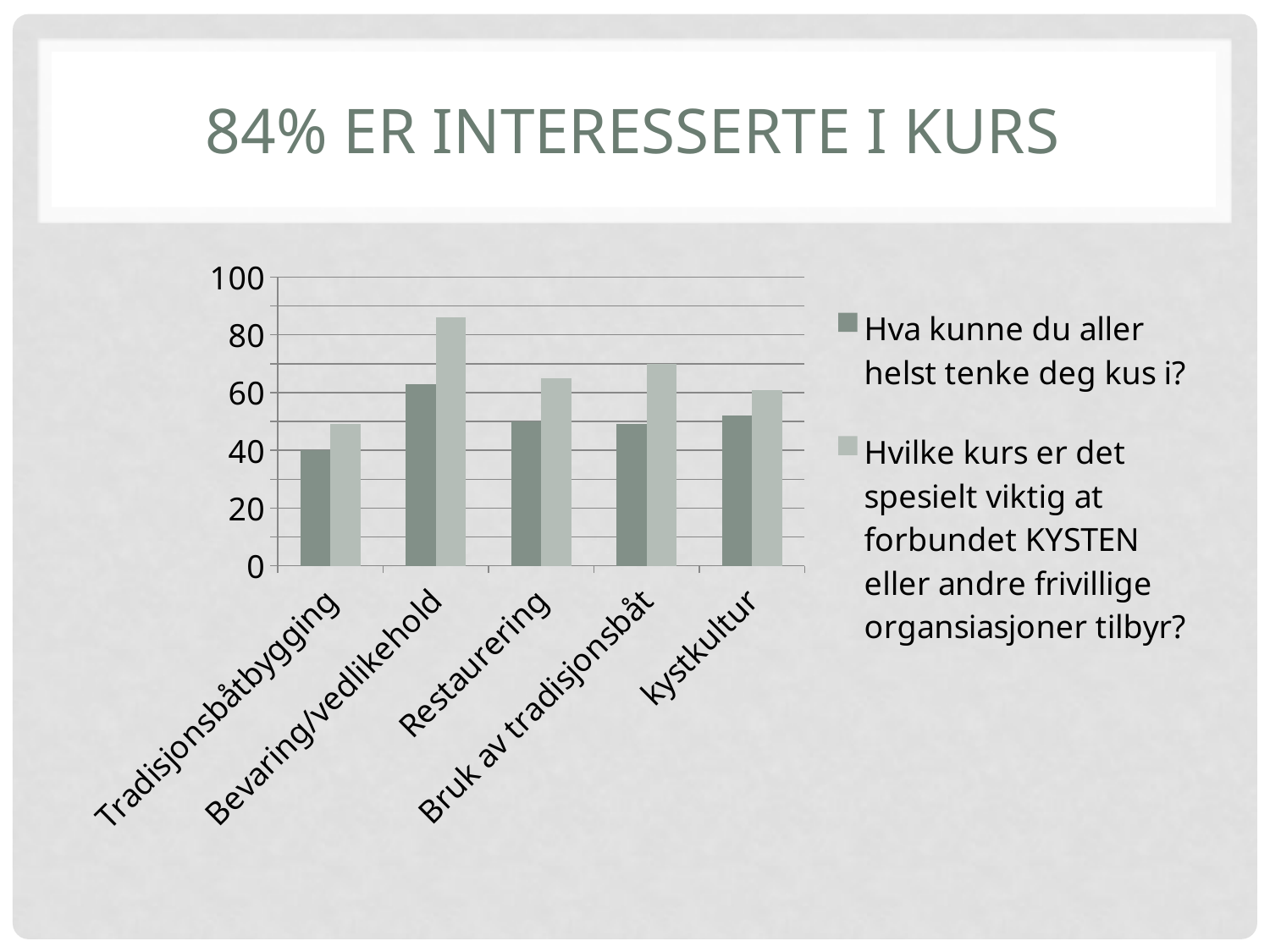
How many categories are shown on the x axis of the chart? 5 Which category has the lowest value for the series 'Hva kunne du aller helst tenke deg kus i?'? Tradisjonsbåtbygging For the series 'Hva kunne du aller helst tenke deg kus i?', which is larger: Bevaring/vedlikehold or kystkultur? Bevaring/vedlikehold How many series does the chart's legend list? 2 Which category has the lowest value for the series 'Hvilke kurs er det spesielt viktig at forbundet KYSTEN eller andre frivillige organsiasjoner tilbyr?'? Tradisjonsbåtbygging What kind of chart is shown on the slide? bar chart Which category has the highest value for the series 'Hva kunne du aller helst tenke deg kus i?'? Bevaring/vedlikehold Is the value for Bevaring/vedlikehold in the series 'Hvilke kurs er det spesielt viktig at forbundet KYSTEN eller andre frivillige organsiasjoner tilbyr?' greater or less than 80? greater Is the value for Tradisjonsbåtbygging in the series 'Hvilke kurs er det spesielt viktig at forbundet KYSTEN eller andre frivillige organsiasjoner tilbyr?' greater or less than 60? less Which category has the highest value for the series 'Hvilke kurs er det spesielt viktig at forbundet KYSTEN eller andre frivillige organsiasjoner tilbyr?'? Bevaring/vedlikehold For Restaurering, which series has the larger value? Hvilke kurs er det spesielt viktig at forbundet KYSTEN eller andre frivillige organsiasjoner tilbyr? Is the value for Bruk av tradisjonsbåt in the series 'Hvilke kurs er det spesielt viktig at forbundet KYSTEN eller andre frivillige organsiasjoner tilbyr?' greater or less than 60? greater